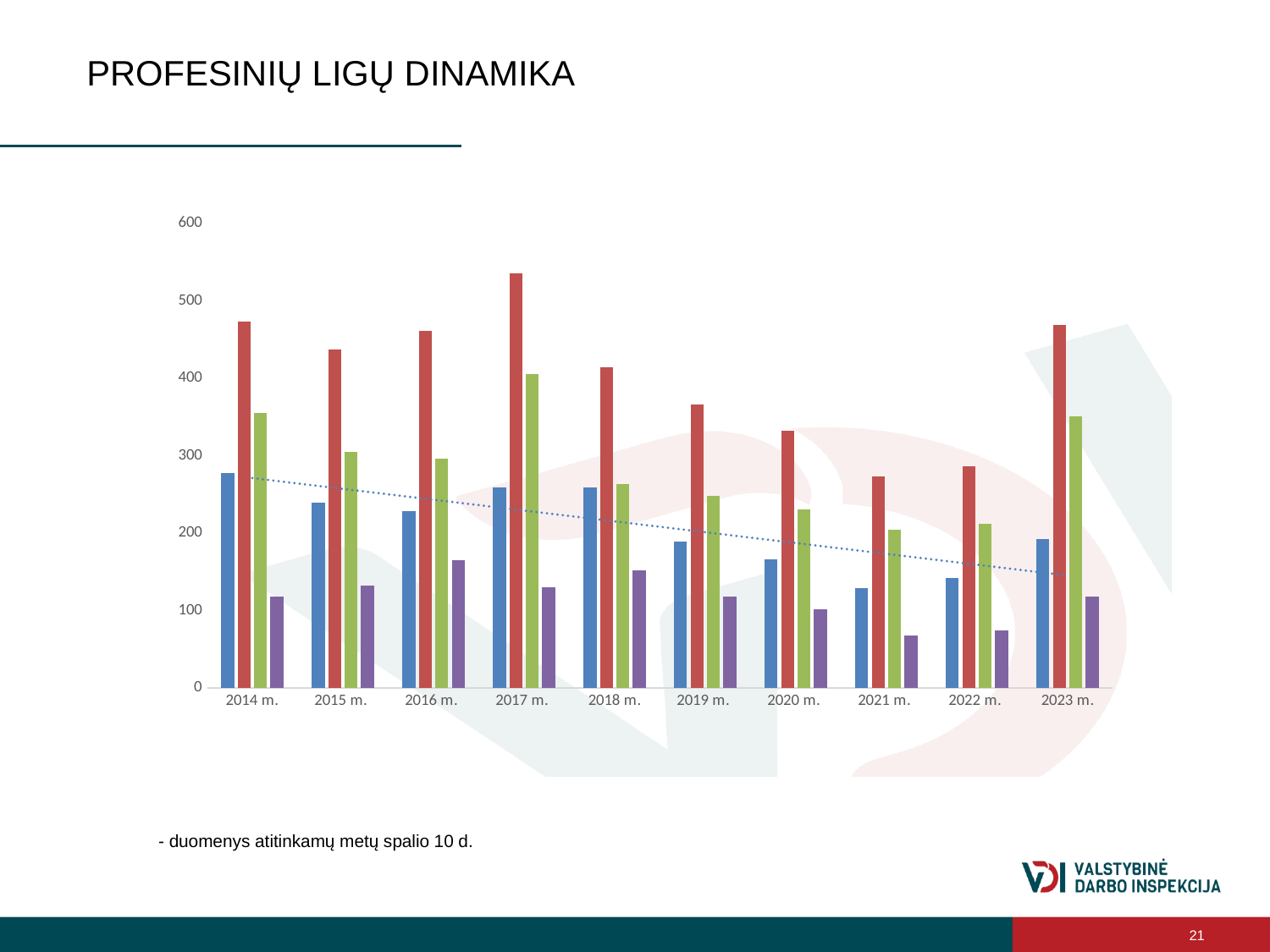
Is the value of the purple bar for 2021 m. greater or less than 100? less Does the dotted trend line in the chart rise or fall from 2014 m. to 2023 m.? fall Which is larger, the blue bar for 2014 m. or the blue bar for 2023 m.? 2014 m. In which year is the purple bar the shortest? 2021 m. In which year is the green bar the tallest? 2017 m. What is the title of the slide containing the chart? PROFESINIŲ LIGŲ DINAMIKA How many years are shown on the x axis of the chart? 10 How many bars are plotted for each year in the chart? 4 In which year is the red bar the tallest? 2017 m. Is the value of the blue bar for 2022 m. greater or less than 200? less Is the value of the red bar for 2017 m. greater or less than 500? greater What kind of chart is shown on the slide? bar chart